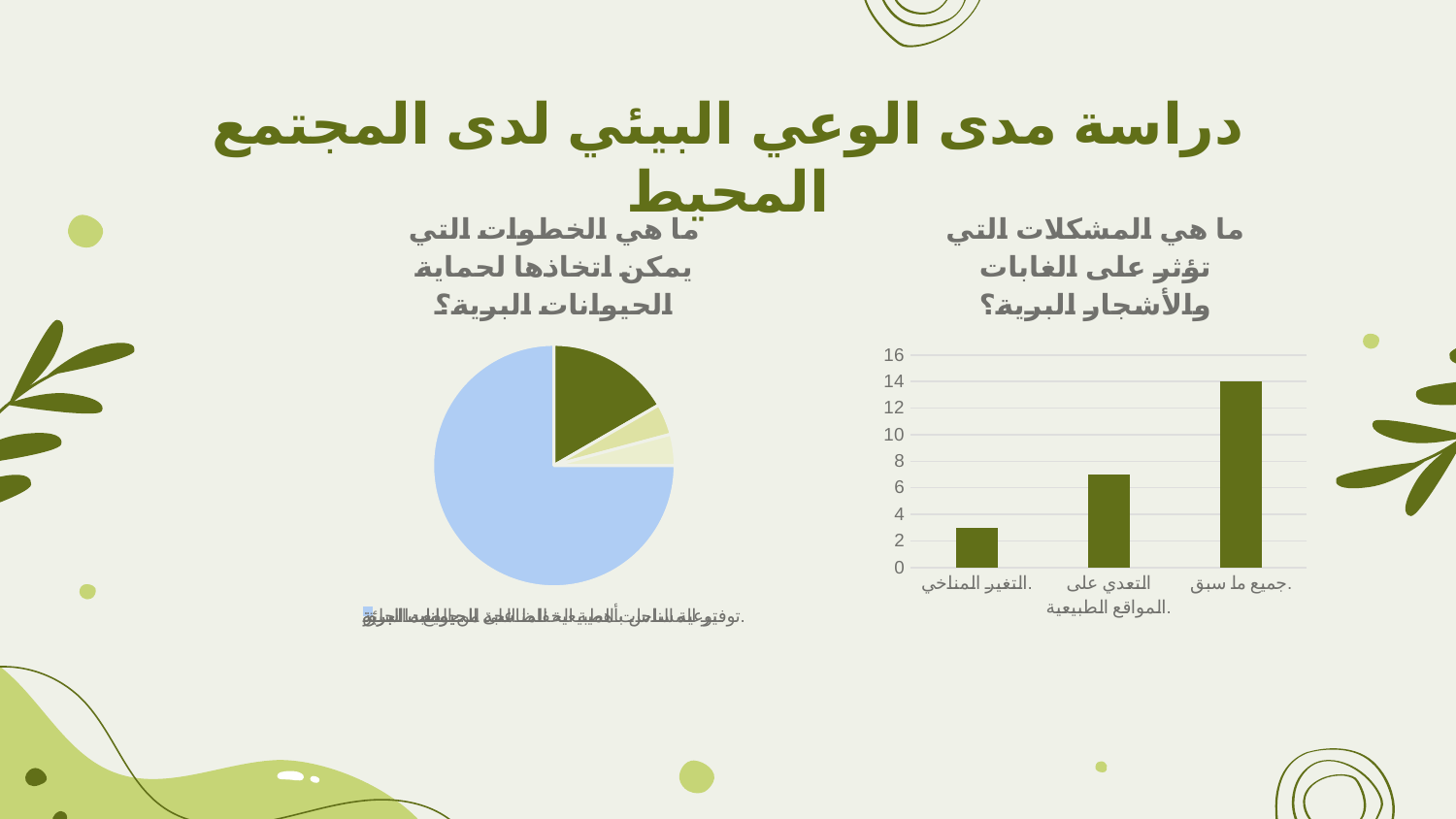
In the bar chart on the right, is the value for "التعدي على المواقع الطبيعية" greater or less than 6? greater In the bar chart on the right, what is the value for "جميع ما سبق"? 14 In the bar chart on the right, is the value for "التغير المناخي" greater or less than 4? less What type of chart is shown under the heading "ما هي الخطوات التي يمكن اتخاذها لحماية الحيوانات البرية؟"? pie chart What type of chart is shown under the heading "ما هي المشكلات التي تؤثر على الغابات والأشجار البرية؟"? bar chart How many categories are shown in the bar chart on the right? 3 In the bar chart on the right, is the value for "التعدي على المواقع الطبيعية" greater or less than 8? less How many slices does the pie chart on the left have? 4 Do the values in the bar chart on the right rise or fall from left to right? rise In the bar chart on the right, which category has the lowest value? التغير المناخي In the bar chart on the right, which is larger: the value for "التعدي على المواقع الطبيعية" or the value for "التغير المناخي"? التعدي على المواقع الطبيعية In the bar chart on the right, which category has the highest value? جميع ما سبق